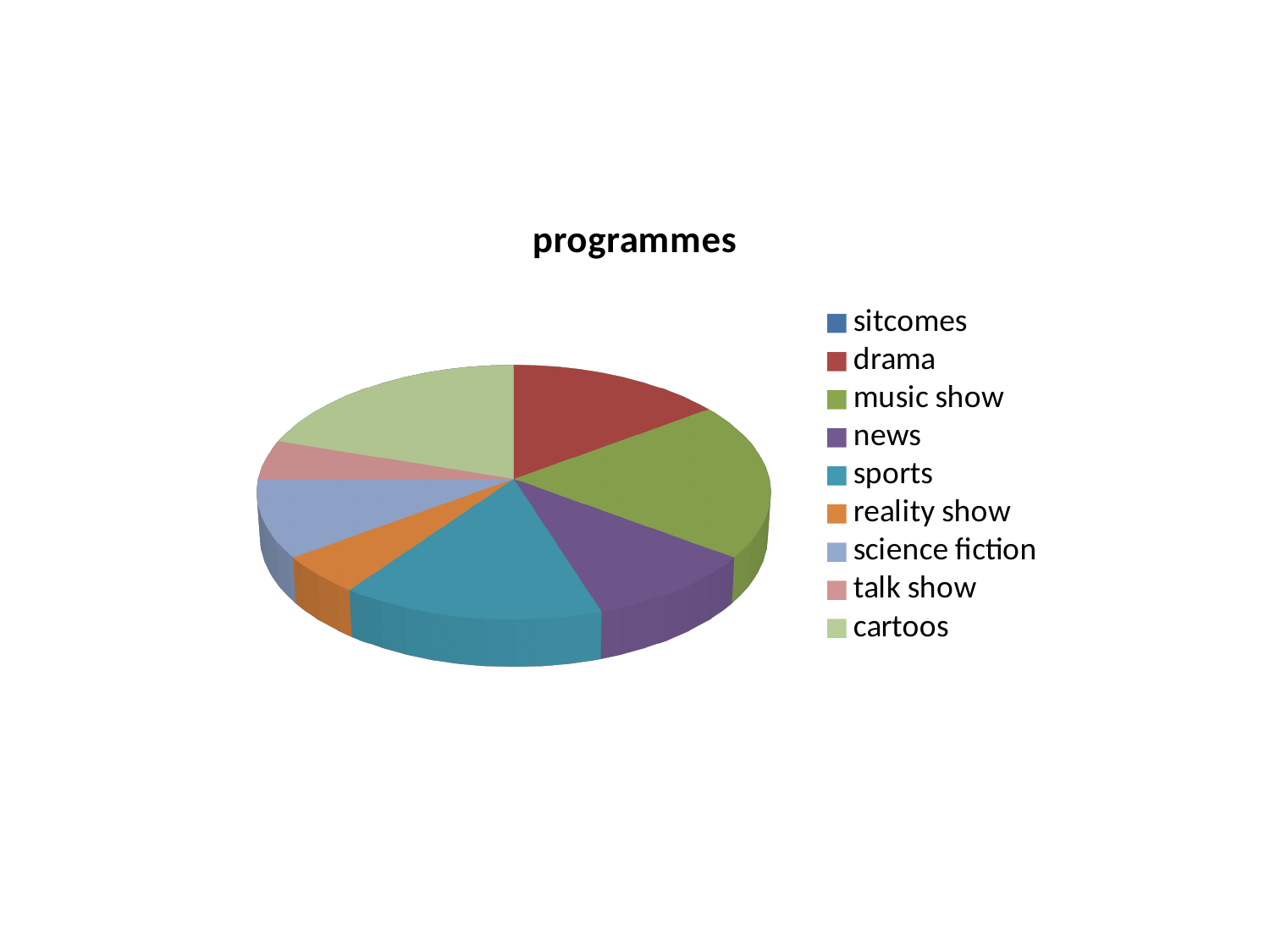
Which is larger in the pie chart, the slice for music show or the slice for science fiction? music show Which is larger in the pie chart, the slice for news or the slice for reality show? news What kind of chart is shown on the slide? pie chart How many categories does the legend of the pie chart list? 9 What is the title of the chart? programmes Which is larger in the pie chart, the slice for cartoos or the slice for talk show? cartoos Which legend entry is listed first in the pie chart's legend? sitcomes